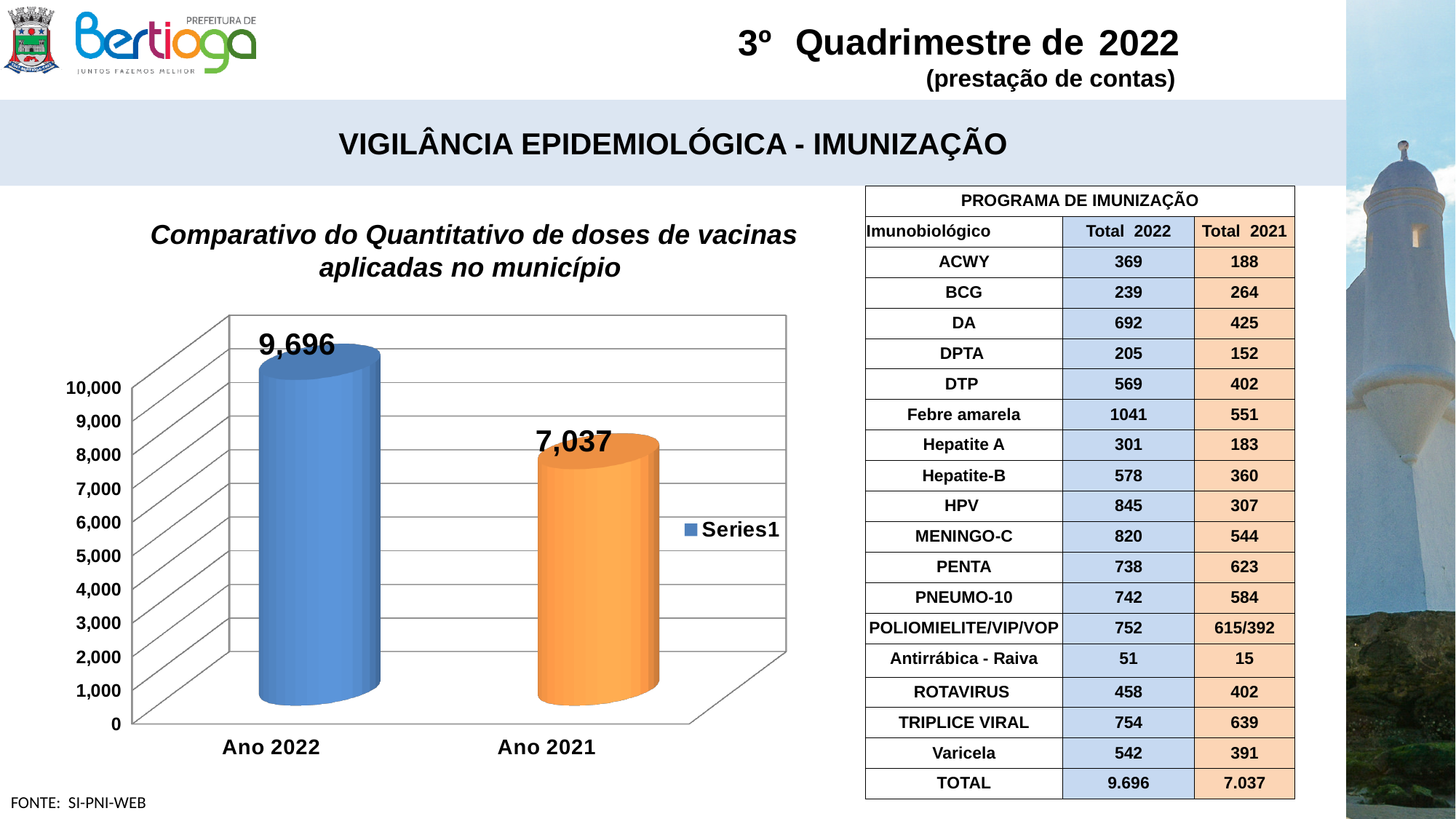
Is the value for Ano 2022 greater or less than 9,000? greater How many categories are shown on the x axis of the chart? 2 Which category has the highest value in the chart? Ano 2022 How many series does the chart legend list? 1 What is the title of the chart? Comparativo do Quantitativo de doses de vacinas aplicadas no município Is the value for Ano 2021 greater or less than 8,000? less What is the value for Ano 2021 in the chart? 7,037 What kind of chart is shown on the slide? bar chart What is the difference between the values for Ano 2022 and Ano 2021? 2,659 Which category has the lowest value in the chart? Ano 2021 Which is larger, the value for Ano 2022 or the value for Ano 2021? Ano 2022 What is the value for Ano 2022 in the chart? 9,696